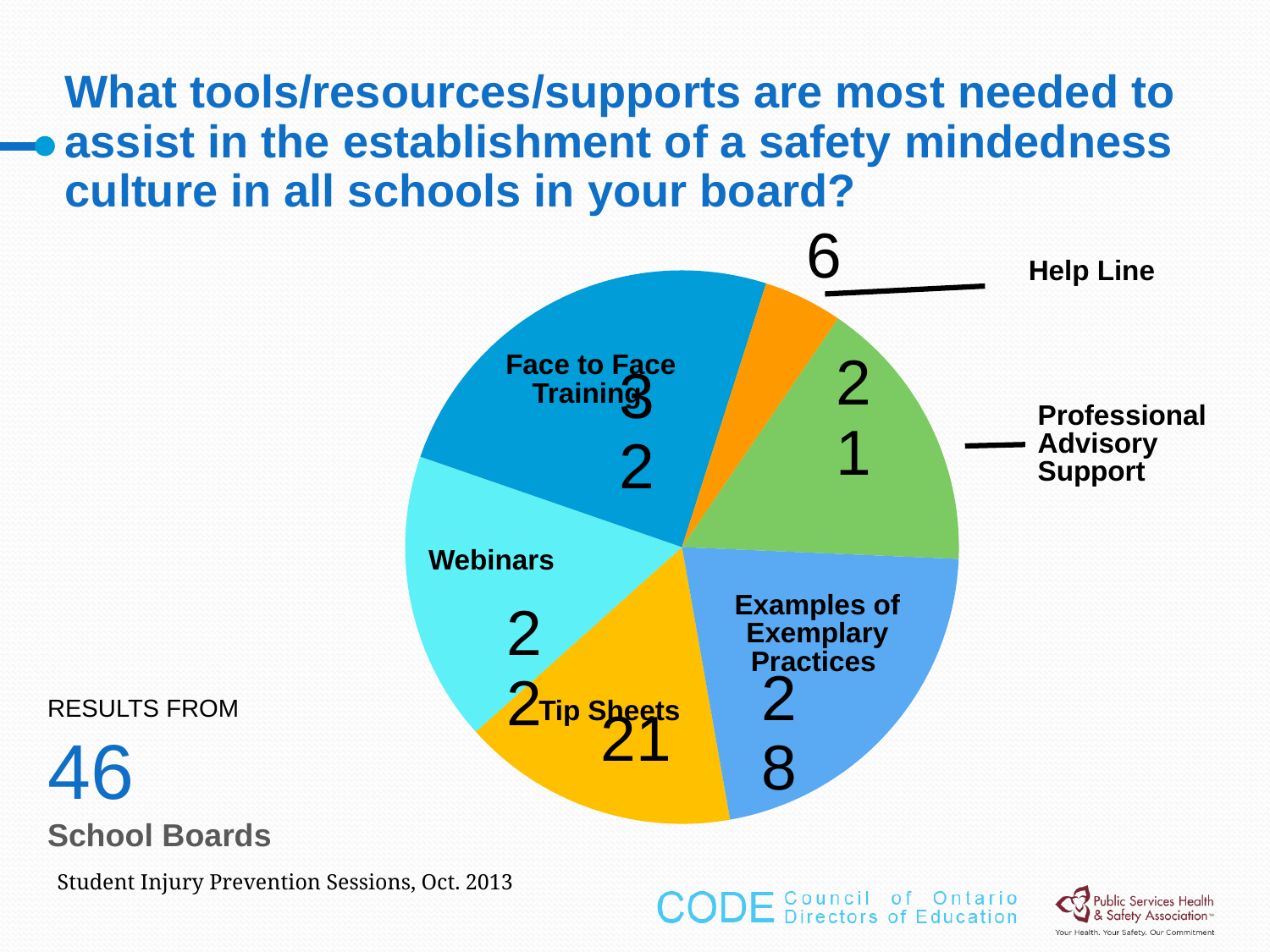
What colour is the Help Line slice? orange Which category has the smallest slice of the pie? Help Line What kind of chart is shown on the slide? pie chart What is the value for Examples of Exemplary Practices? 28 What is the value for Professional Advisory Support? 21 What is the value for Face to Face Training? 32 What is the value for Webinars? 22 Which category has the largest slice of the pie? Face to Face Training What is the difference between the values for Face to Face Training and Help Line? 26 How many categories (slices) does the pie chart have? 6 Which is larger, Examples of Exemplary Practices or Professional Advisory Support? Examples of Exemplary Practices What is the value for Help Line? 6